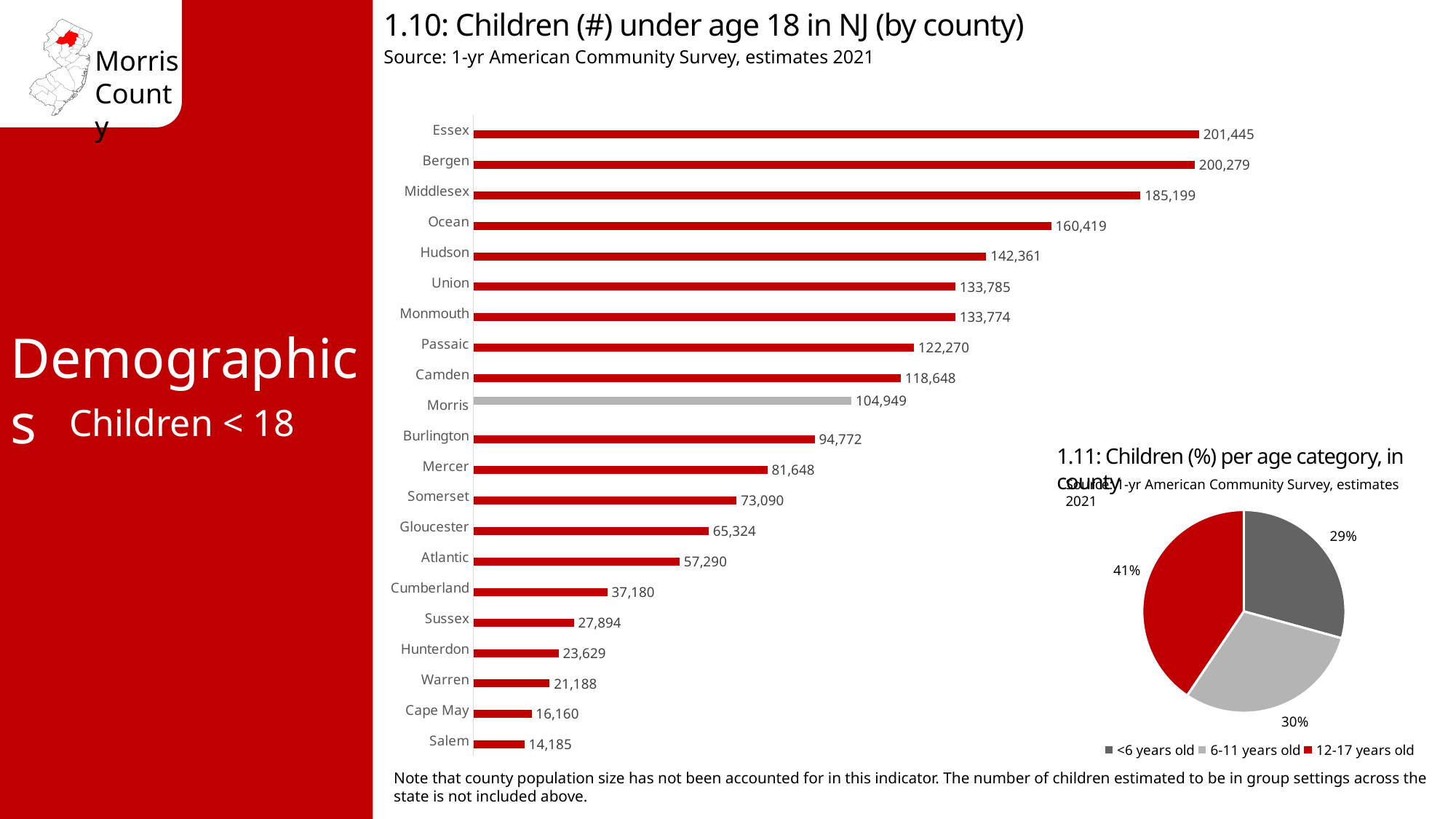
In chart 1.10, how many children under age 18 are in Morris County? 104,949 In chart 1.10, what is the difference between the values for Morris and Burlington? 10,177 In chart 1.10, which county's bar is shown in grey instead of red? Morris In chart 1.10, which county has more children under 18, Hudson or Passaic? Hudson What type of chart is chart 1.10? Bar chart In chart 1.10, how many counties are shown? 21 In chart 1.11, which age category has the smallest share? <6 years old How many age categories does the legend of chart 1.11 list? 3 In chart 1.10, what is the value for Ocean County? 160,419 In chart 1.11, what percentage of children are 12-17 years old? 41% In chart 1.10, which county has the highest number of children under 18? Essex In chart 1.10, which county has the lowest number of children under 18? Salem